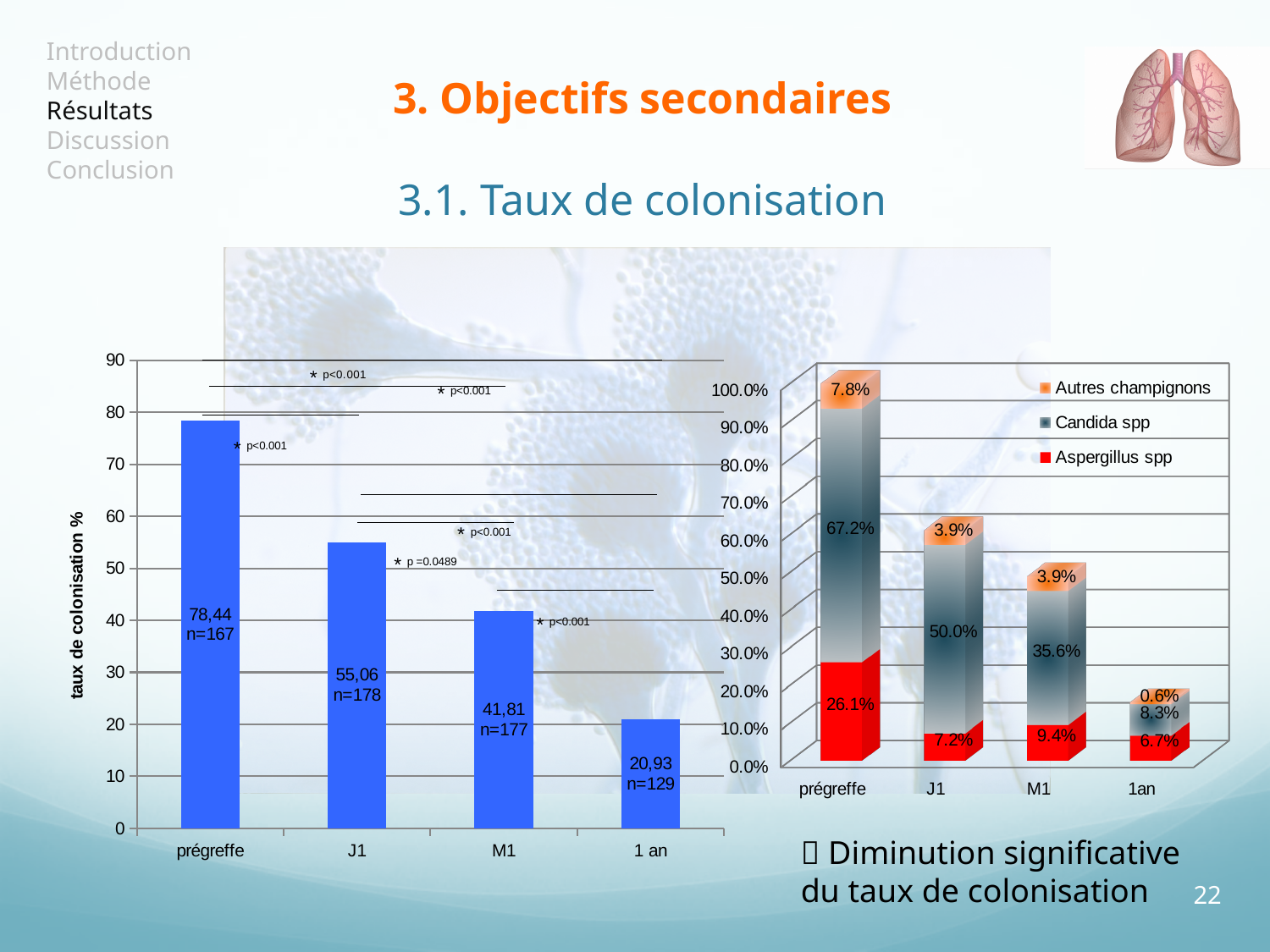
In the left bar chart, how many time points are shown on the x axis? 4 In the left bar chart, what is the colonisation rate at 1 an? 20,93 In the right stacked bar chart, how many series does the legend list? 3 In the right stacked bar chart, which is larger at M1: Aspergillus spp or Candida spp? Candida spp In the left bar chart, what is the sample size (n) for J1? n=178 In the left bar chart, which time point has the lowest colonisation rate? 1 an In the left bar chart, do the values rise or fall from prégreffe to 1 an? fall In the left bar chart, what is the colonisation rate for prégreffe? 78,44 In the right stacked bar chart, what is the value for Aspergillus spp at prégreffe? 26.1% In the right stacked bar chart, what is the total of the 1an bar? 15.6% In the left bar chart, what is the difference between the colonisation rate at prégreffe and at 1 an? 57,51 In the right stacked bar chart, what is the value for Candida spp at J1? 50.0%